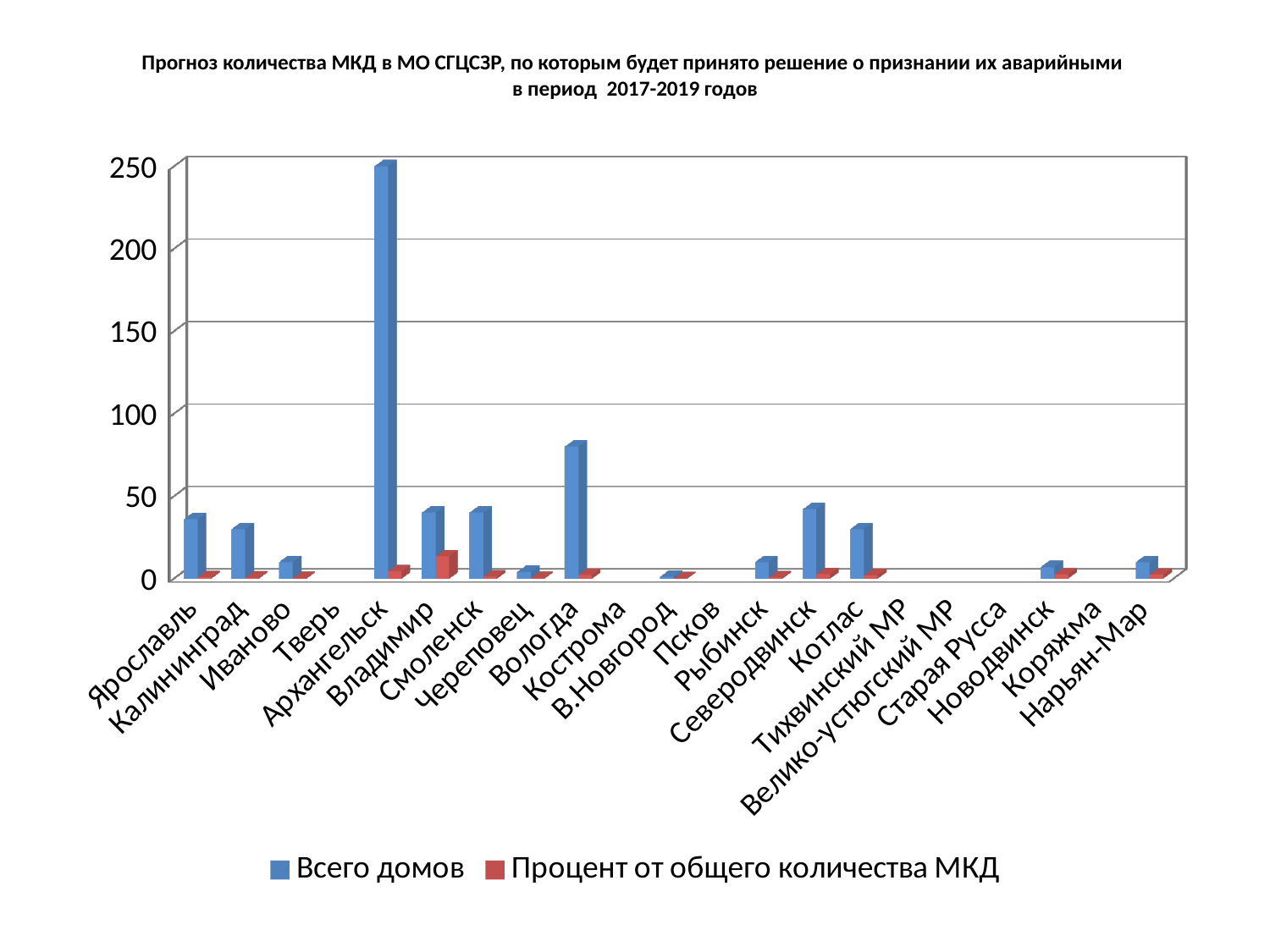
Is the value for Всего домов in Вологда greater or less than 100? less Is the value for Всего домов in Ярославль greater or less than 50? less How many series does the legend list? 2 Which category has the highest value for Всего домов? Архангельск Which is larger, the Всего домов value for Калининград or for Иваново? Калининград Is the value for Всего домов in Архангельск greater or less than 200? greater What kind of chart is shown on the slide? bar chart What colour are the bars for the series Всего домов? blue Which is larger, the Всего домов value for Вологда or for Северодвинск? Вологда How many categories are shown on the x axis? 21 Which category has the highest value for Процент от общего количества МКД? Владимир